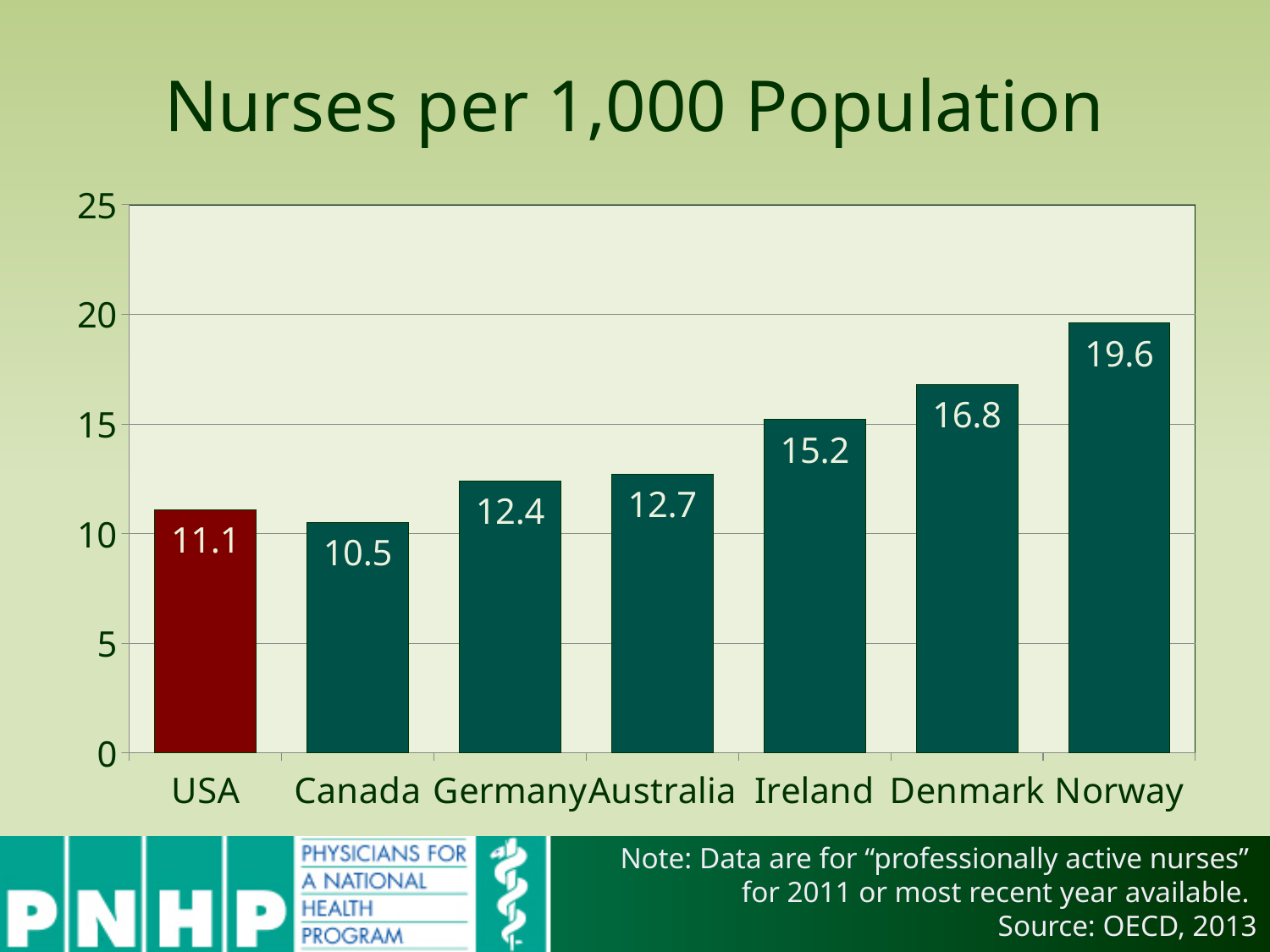
Which country has the lowest number of nurses per 1,000 population? Canada Which country's bar is coloured differently (dark red) from the others? USA What is the difference between the values for Germany and Canada? 1.9 What kind of chart is shown on the slide? Bar chart How many countries are shown in the chart? 7 What is the value for Ireland? 15.2 Which has a larger value, Australia or Ireland? Ireland What is the value for the USA? 11.1 Which country has the highest number of nurses per 1,000 population? Norway What is the value for Denmark? 16.8 What is the difference between the values for Norway and the USA? 8.5 Is the value for Denmark greater or less than 15? greater